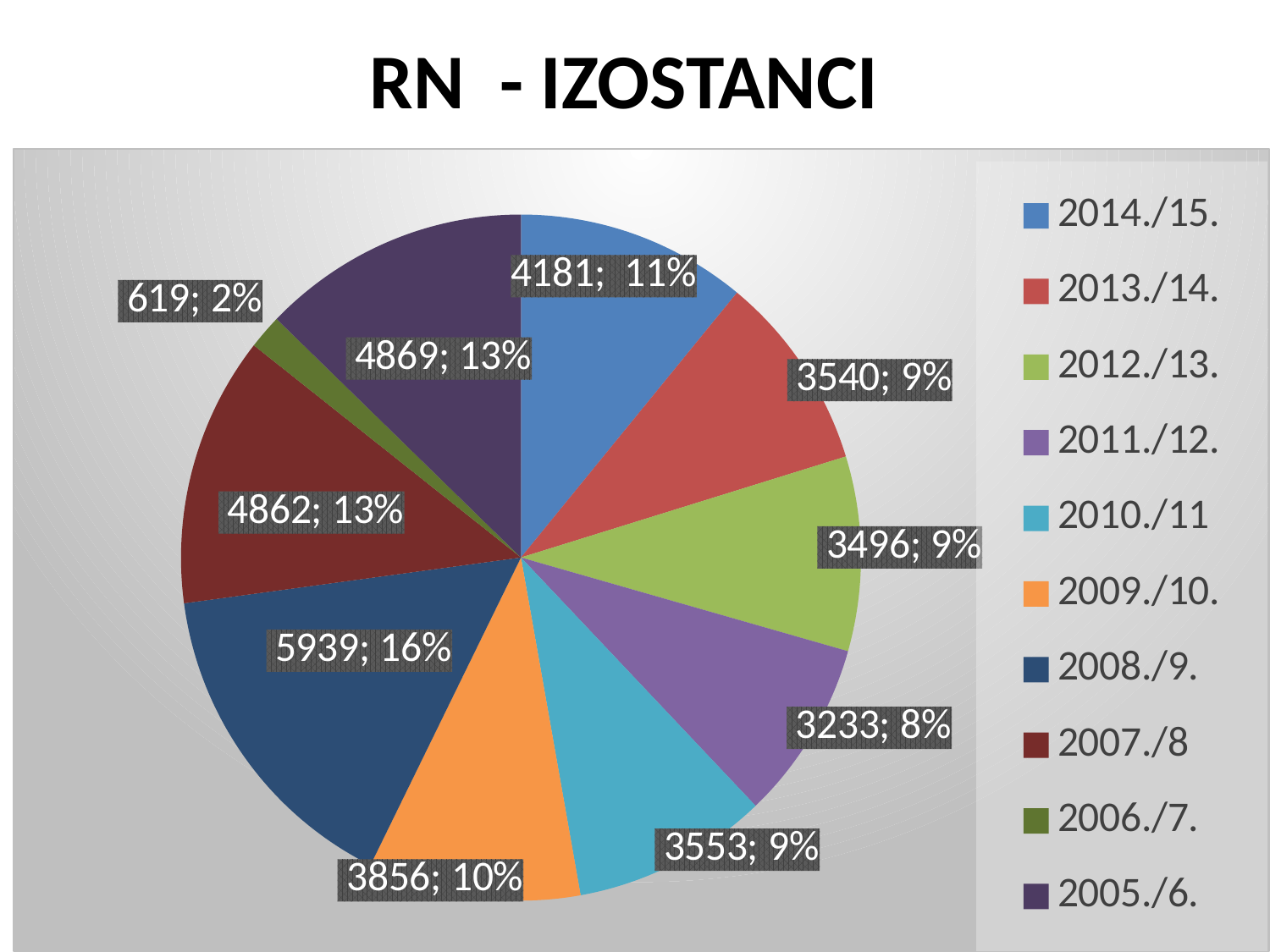
What is the value for 2014./15.? 4181 How many categories does the pie chart have? 10 What share of the pie does 2005./6. represent? 13% What is the title of the chart? RN - IZOSTANCI What is the value for 2008./9.? 5939 What is the difference between the values for 2008./9. and 2007./8? 1077 Which is larger, the value for 2013./14. or the value for 2011./12.? 2013./14. Which school year has the smallest slice? 2006./7. What is the value for 2006./7.? 619 What type of chart is shown on the slide? pie chart What share of the pie does 2009./10. represent? 10% Which school year has the largest slice? 2008./9.